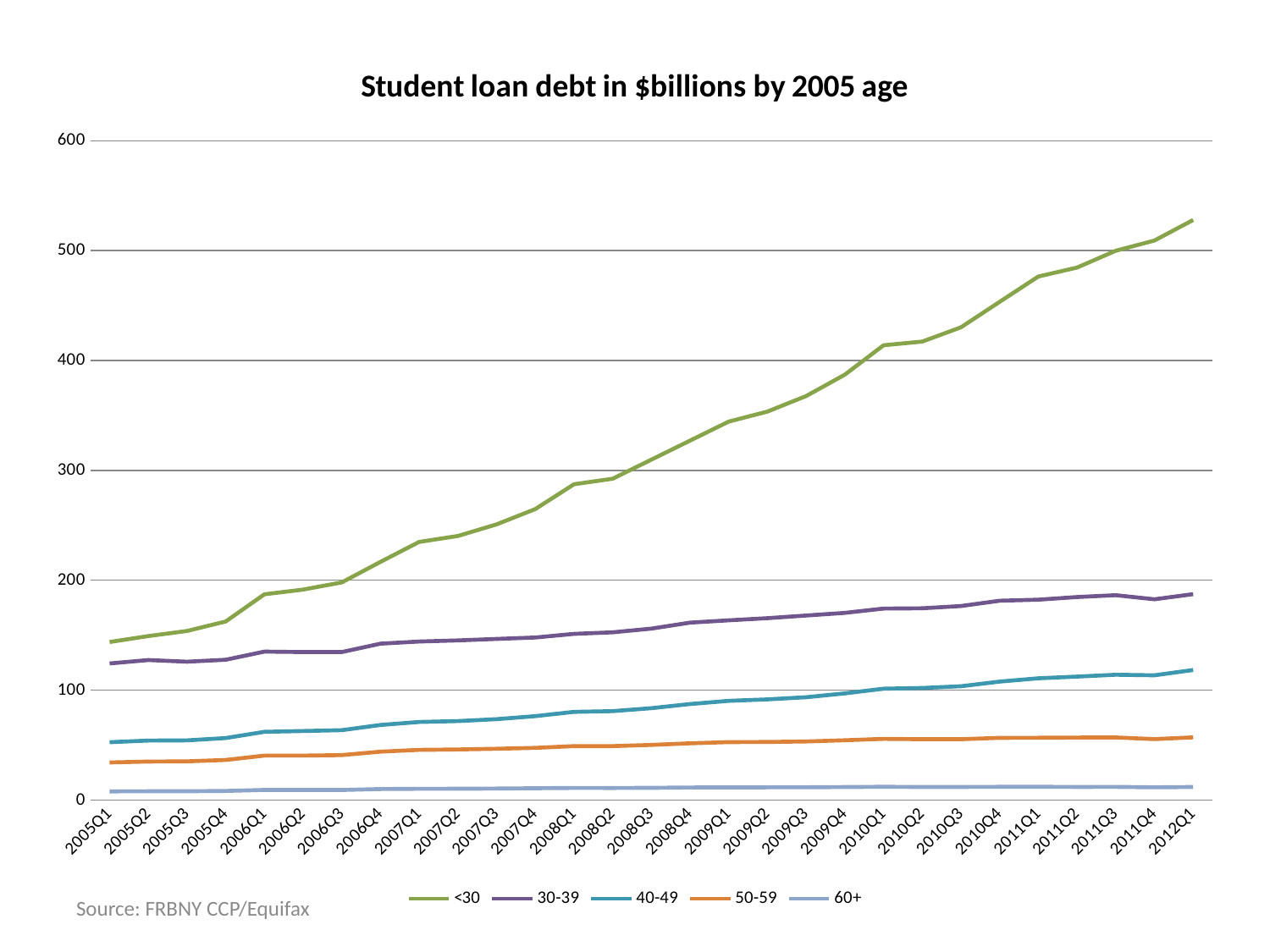
Which age group has the lowest student loan debt in 2012Q1? 60+ Which is larger in 2012Q1, the value for the 30-39 group or the 40-49 group? 30-39 Which age group has the highest student loan debt in 2012Q1? <30 What kind of chart is shown on the slide? line chart Is the value for the 40-49 group in 2012Q1 greater or less than 100? greater What is the title of the chart? Student loan debt in $billions by 2005 age How many quarters are plotted along the x axis? 29 Is the value for the 50-59 group in 2012Q1 greater or less than 100? less Does the student loan debt for the <30 group rise or fall from 2005Q1 to 2012Q1? rise How many series does the legend list? 5 Is the value for the <30 group in 2005Q1 greater or less than 200? less